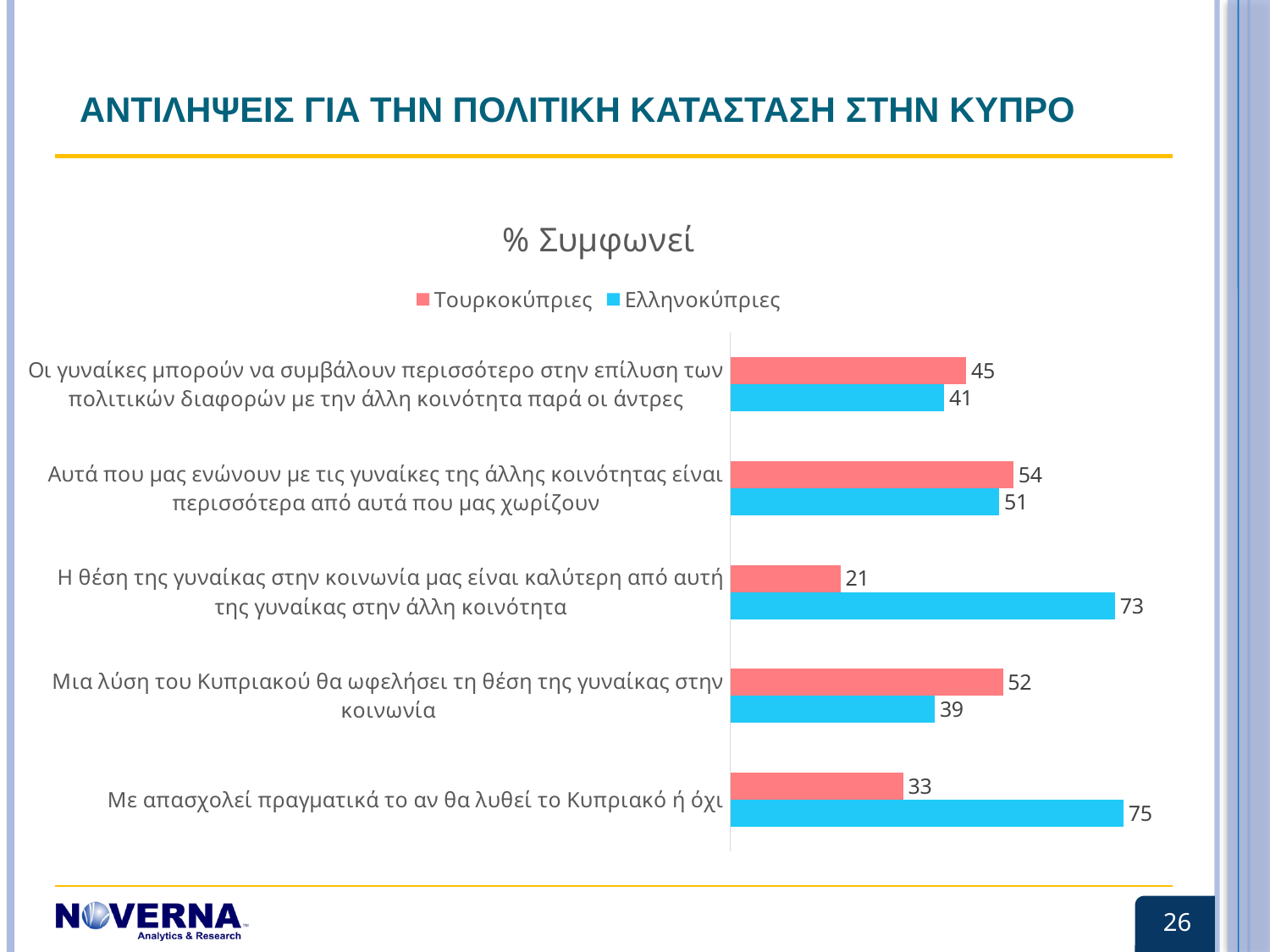
What is the difference between Ελληνοκύπριες and Τουρκοκύπριες on the statement "Η θέση της γυναίκας στην κοινωνία μας είναι καλύτερη από αυτή της γυναίκας στην άλλη κοινότητα"? 52 What kind of chart is shown on the slide? Bar chart On the statement "Αυτά που μας ενώνουν με τις γυναίκες της άλλης κοινότητας είναι περισσότερα από αυτά που μας χωρίζουν", which group has the higher value, Τουρκοκύπριες or Ελληνοκύπριες? Τουρκοκύπριες Which statement has the lowest value for Τουρκοκύπριες? Η θέση της γυναίκας στην κοινωνία μας είναι καλύτερη από αυτή της γυναίκας στην άλλη κοινότητα What is the value for Τουρκοκύπριες on the statement "Μια λύση του Κυπριακού θα ωφελήσει τη θέση της γυναίκας στην κοινωνία"? 52 Which statement has the highest value for Ελληνοκύπριες? Με απασχολεί πραγματικά το αν θα λυθεί το Κυπριακό ή όχι How many series does the legend list? 2 How many statements are shown in the chart? 5 What is the title of the chart? % Συμφωνεί What is the value for Ελληνοκύπριες on the statement "Με απασχολεί πραγματικά το αν θα λυθεί το Κυπριακό ή όχι"? 75 What is the value for Τουρκοκύπριες on the statement "Η θέση της γυναίκας στην κοινωνία μας είναι καλύτερη από αυτή της γυναίκας στην άλλη κοινότητα"? 21 What is the difference between Τουρκοκύπριες and Ελληνοκύπριες on the statement "Μια λύση του Κυπριακού θα ωφελήσει τη θέση της γυναίκας στην κοινωνία"? 13